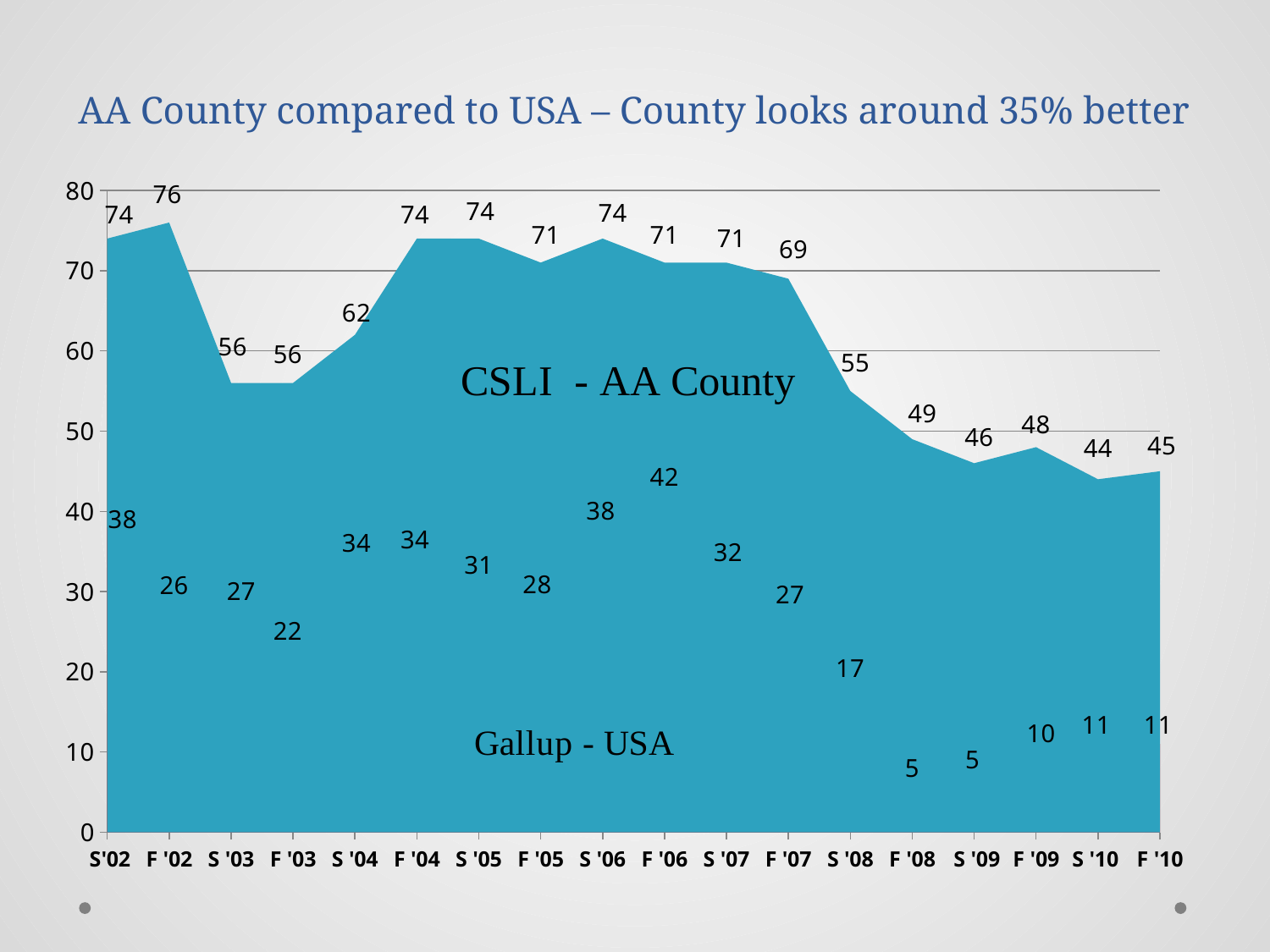
Does the CSLI - AA County value rise or fall from F '07 to F '08? Fall What is the title of the slide? AA County compared to USA – County looks around 35% better In which period is the CSLI - AA County value highest? F '02 What is the Gallup - USA value for S '08? 17 What is the CSLI - AA County value for F '10? 45 What is the CSLI - AA County value for F '02? 76 What is the Gallup - USA value for F '06? 42 What is the lowest Gallup - USA value shown? 5 Which is larger, the CSLI - AA County value for S '03 or for S '04? S '04 What kind of chart is shown on the slide? Area chart What is the difference between the CSLI - AA County value and the Gallup - USA value for S '02? 36 How many time periods are shown on the x axis? 18